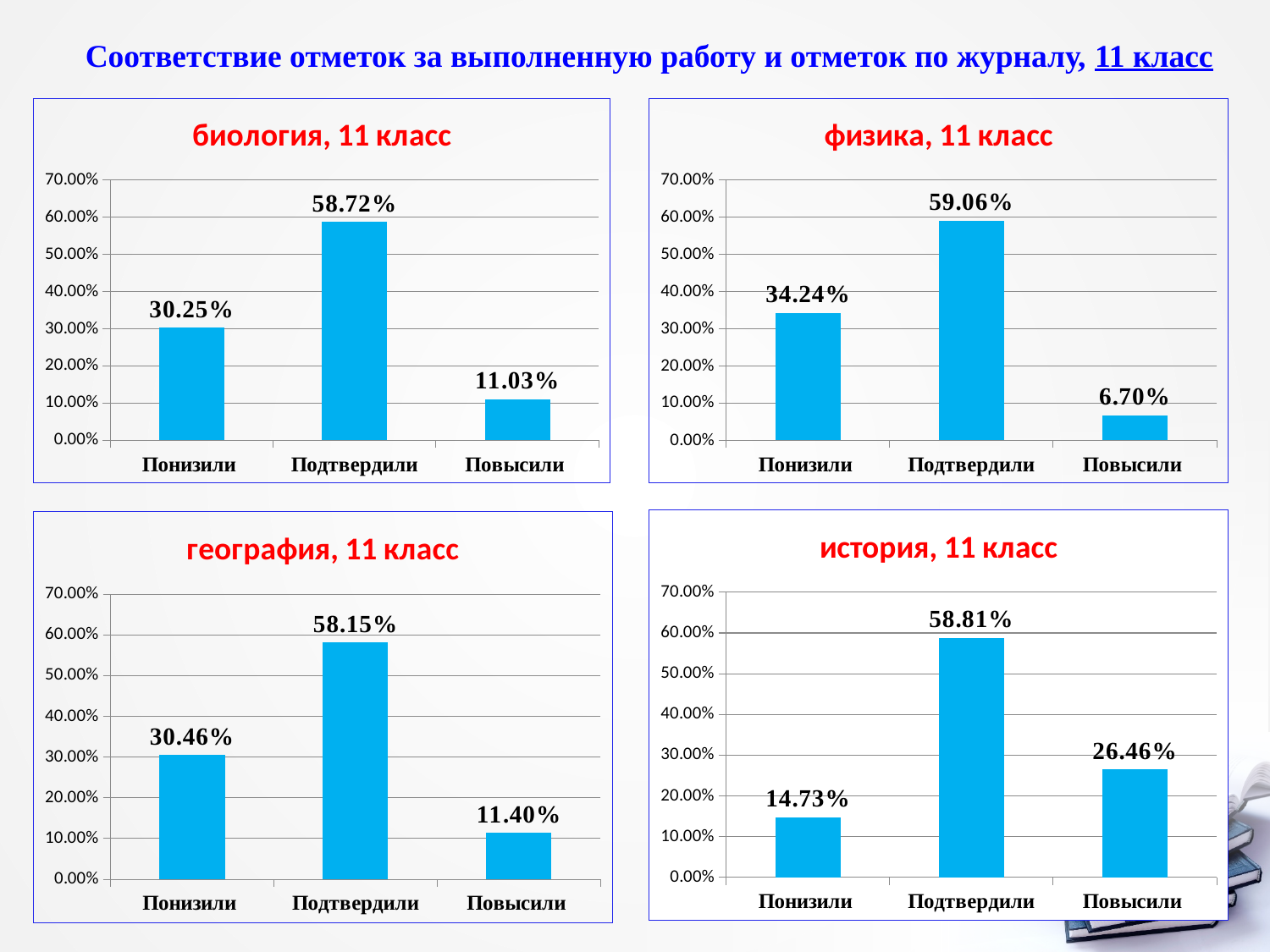
In the chart titled "биология, 11 класс", what is the value for Подтвердили? 58.72% How many charts are shown on the slide? 4 In the chart titled "история, 11 класс", which is larger: the value for Понизили or the value for Повысили? Повысили In the chart titled "физика, 11 класс", which category has the highest value? Подтвердили In the chart titled "история, 11 класс", what is the value for Повысили? 26.46% In the chart titled "география, 11 класс", what is the value for Понизили? 30.46% How many categories are shown in the chart titled "физика, 11 класс"? 3 What kind of chart is the chart titled "география, 11 класс"? bar chart In the chart titled "география, 11 класс", is the value for Повысили greater or less than 20.00%? less In the chart titled "физика, 11 класс", what is the value for Повысили? 6.70% In the chart titled "биология, 11 класс", what is the difference between the values for Подтвердили and Понизили? 28.47% In the chart titled "история, 11 класс", which category has the lowest value? Понизили